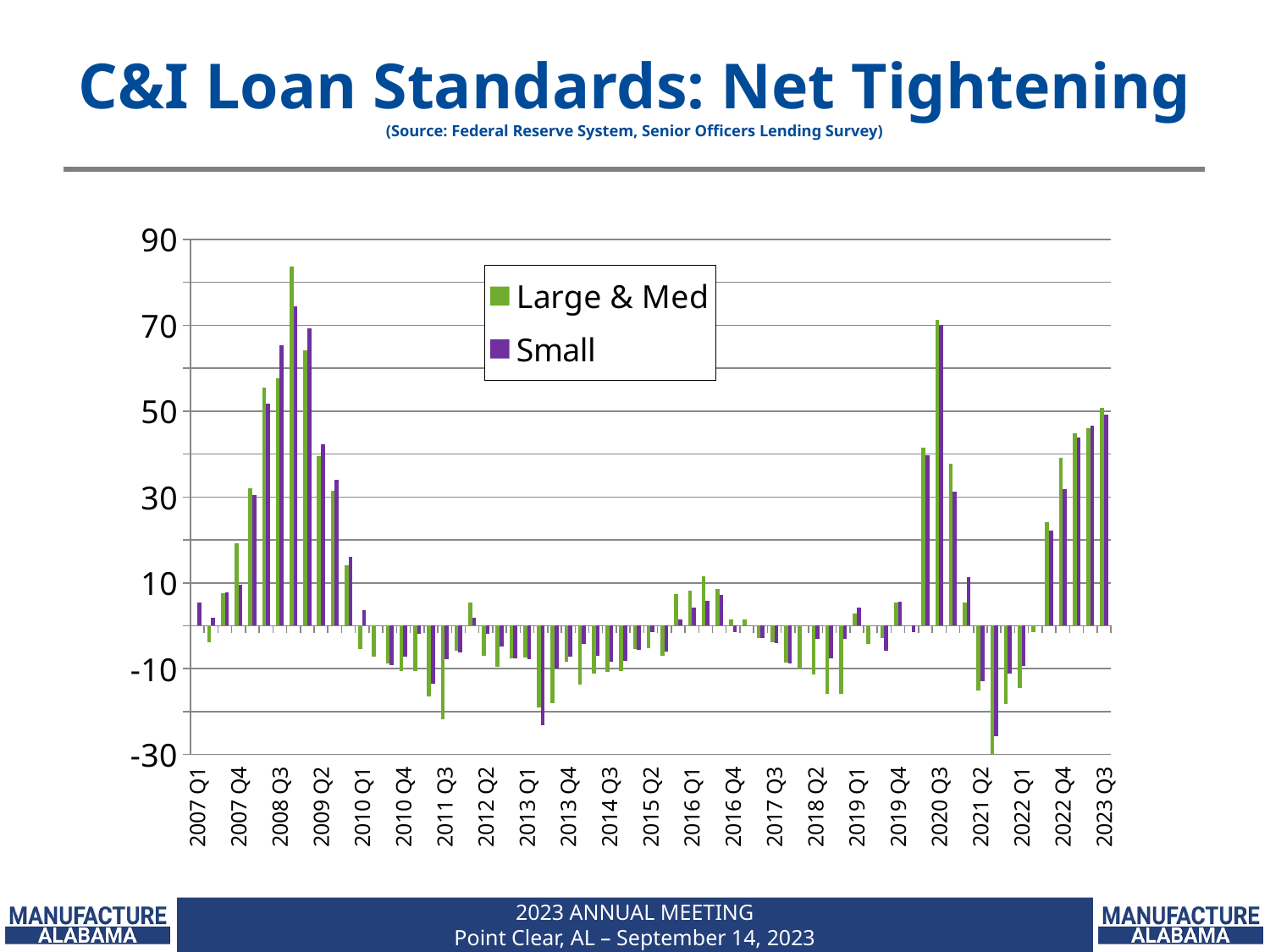
Do the Large & Med values rise or fall from 2007 Q1 to 2008 Q3? Rise What kind of chart is shown on the slide? Bar chart Which colour represents the Small series in the legend? Purple Which series reaches the highest value anywhere on the chart? Large & Med Is the Large & Med value for 2007 Q1 greater or less than 10? less Is the Large & Med value for 2023 Q3 greater or less than 30? greater Is the Large & Med value for 2020 Q3 greater or less than 50? greater What is the title of the chart? C&I Loan Standards: Net Tightening Which is larger, the Large & Med value for 2020 Q3 or the Large & Med value for 2023 Q3? 2020 Q3 How many series does the legend list? 2